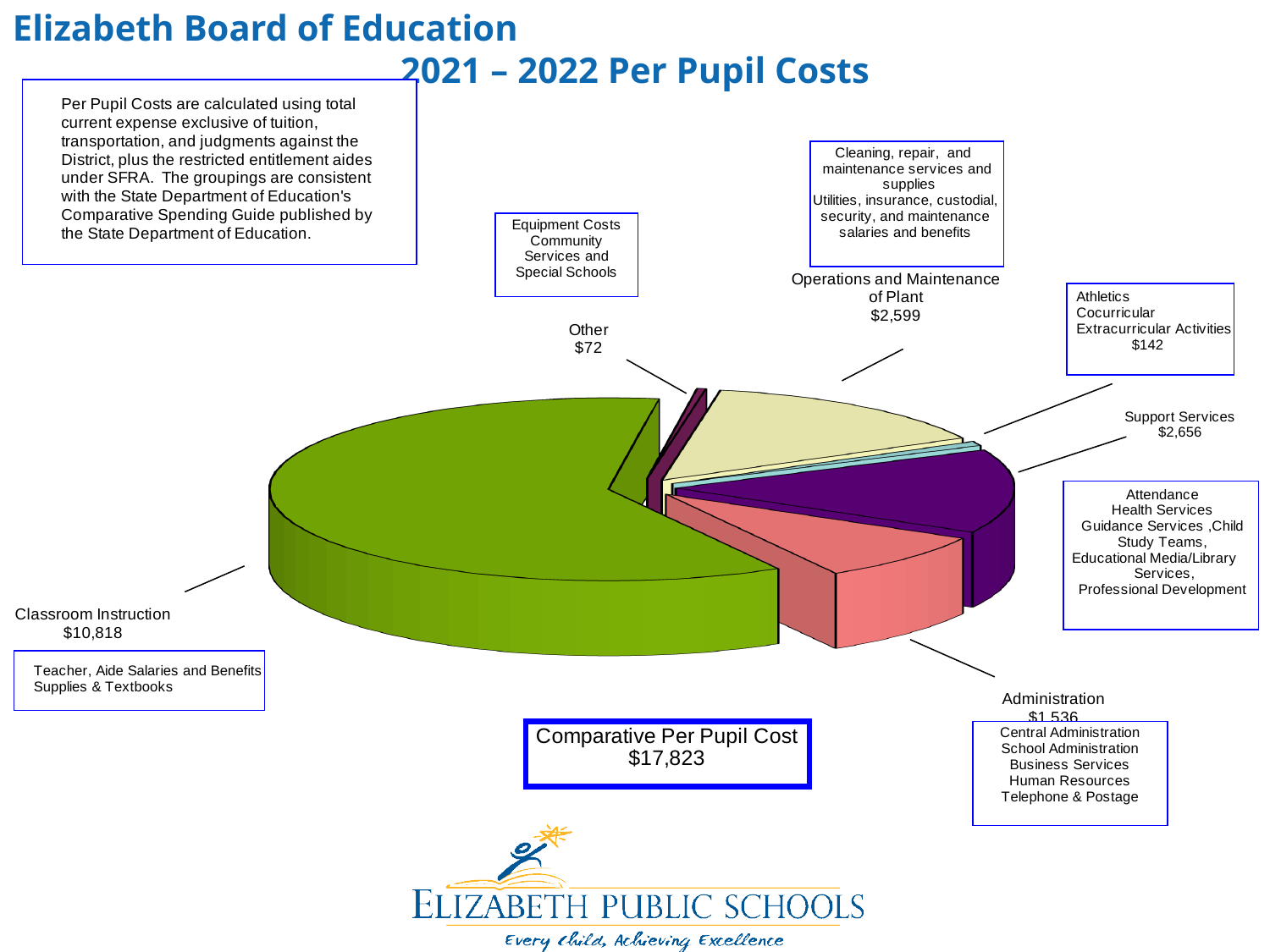
Which category has the largest per pupil cost? Classroom Instruction What is the per pupil cost for Classroom Instruction? $10,818 Which is larger, the per pupil cost for Support Services or for Operations and Maintenance of Plant? Support Services Which category has the smallest per pupil cost? Other What is the per pupil cost for Athletics, Cocurricular and Extracurricular Activities? $142 What is the Comparative Per Pupil Cost shown on the slide? $17,823 What is the difference between the Support Services cost and the Operations and Maintenance of Plant cost? $57 What is the per pupil cost for Support Services? $2,656 How many categories are shown in the pie chart? 6 What is the per pupil cost for the Other category? $72 What is the per pupil cost for Operations and Maintenance of Plant? $2,599 What type of chart is shown on the slide? Pie chart